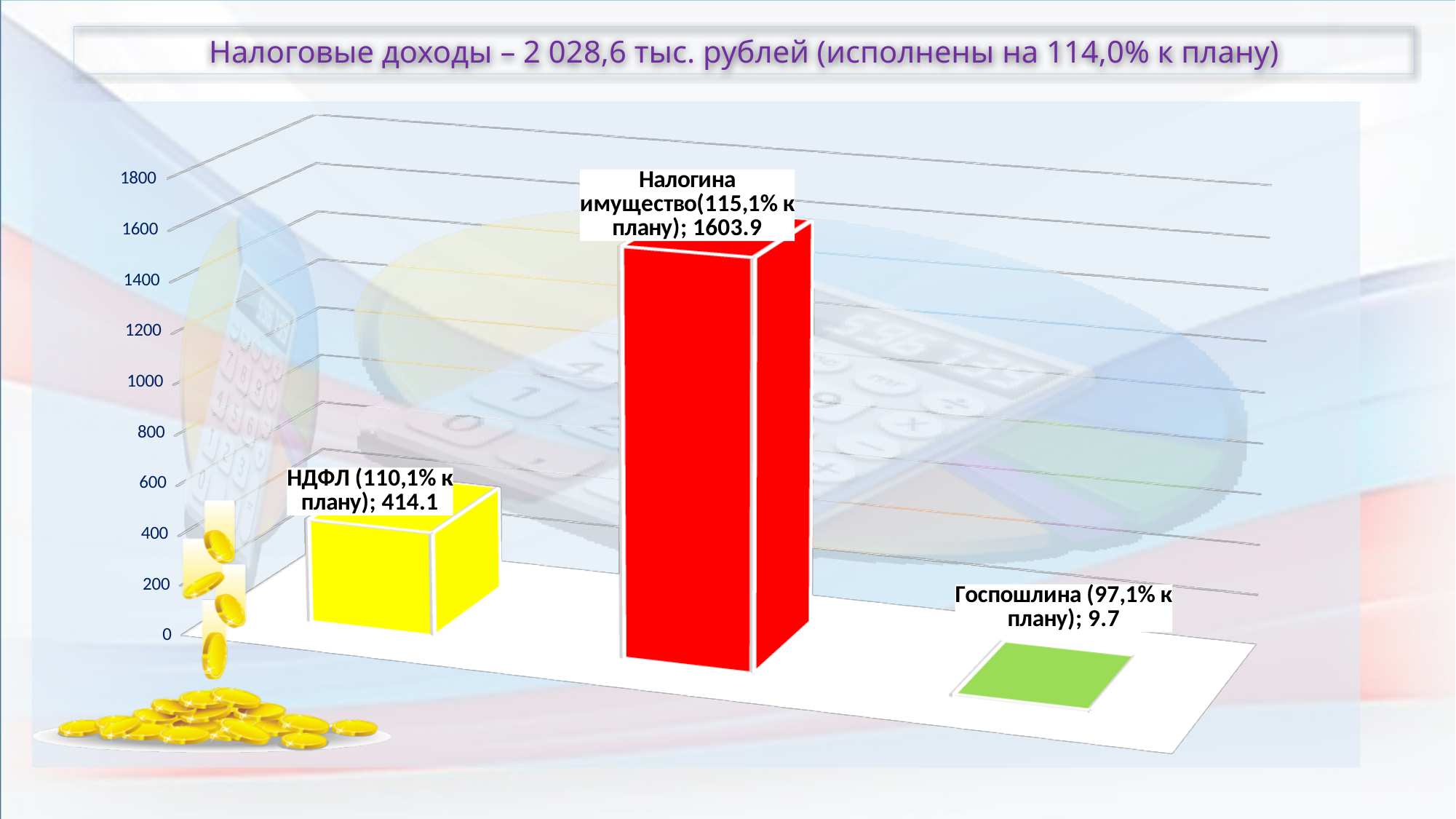
Which category has the lowest value? Госпошлина What is the value shown for Госпошлина? 9.7 Which category has the highest value? Налог на имущество What colour is the bar for Налог на имущество? red What is the value shown for НДФЛ? 414.1 How many categories are shown in the chart? 3 What is the difference between the values for Налог на имущество and НДФЛ? 1189.8 Which is larger, the value for НДФЛ or the value for Госпошлина? НДФЛ What is the value shown for Налог на имущество? 1603.9 What percentage of plan is shown for Госпошлина in its data label? 97,1% What kind of chart is shown on the slide? bar chart Is the value for НДФЛ greater or less than 600? less